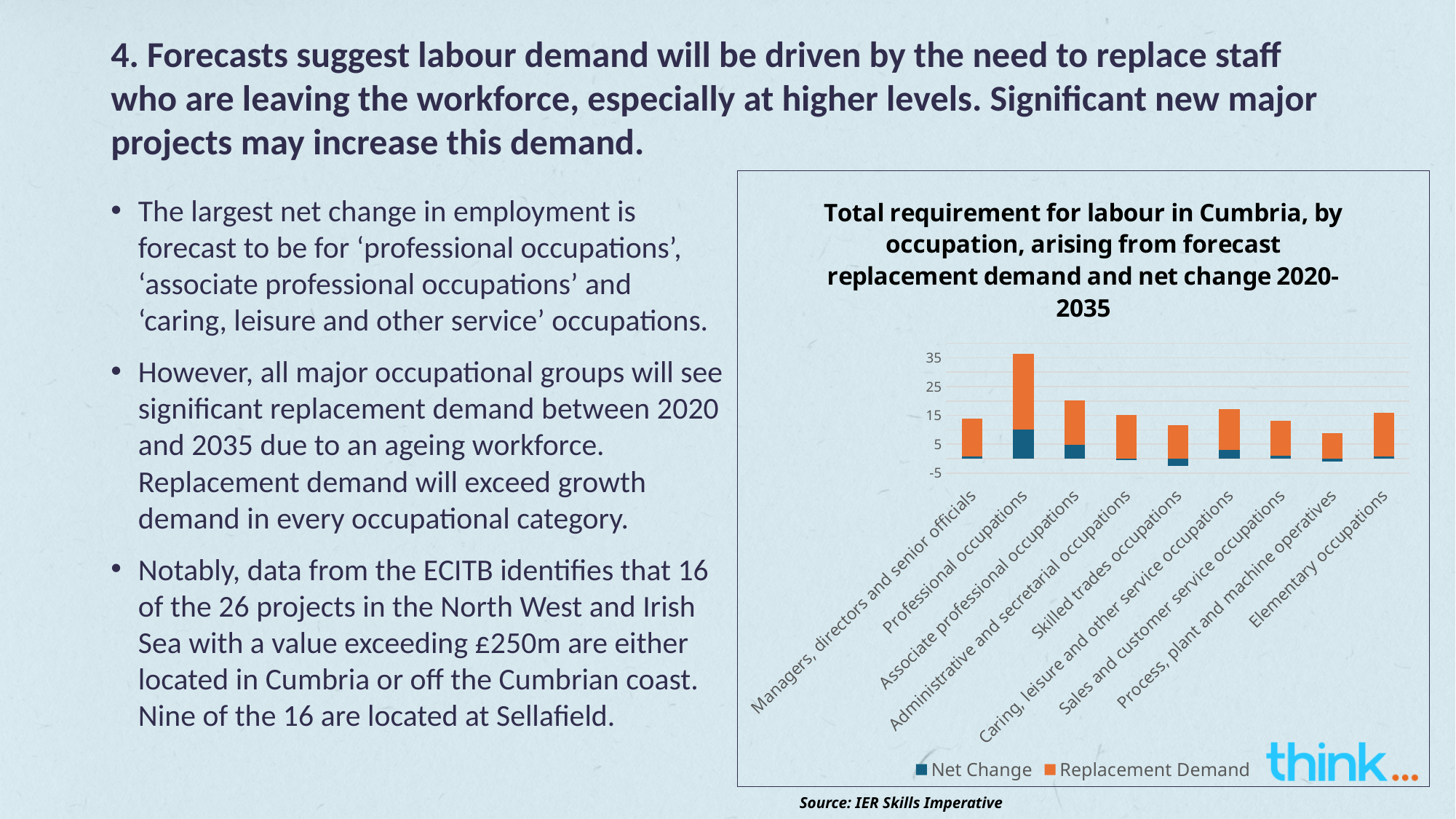
Is the Net Change value for Professional occupations greater or less than 5? greater Which occupation has the lowest total requirement for labour in the chart? Process, plant and machine operatives Which occupation has the largest Net Change segment in the chart? Professional occupations How many occupation categories are shown on the x axis of the chart? 9 What kind of chart is shown on the slide? Stacked bar chart How many series does the chart's legend list? 2 Is the total bar for Professional occupations greater or less than 25? greater Which has the larger total bar: Professional occupations or Associate professional occupations? Professional occupations Which colour represents Replacement Demand in the chart's legend? Orange Which occupation has the highest total requirement for labour in the chart? Professional occupations Is the total bar for Process, plant and machine operatives greater or less than 15? less